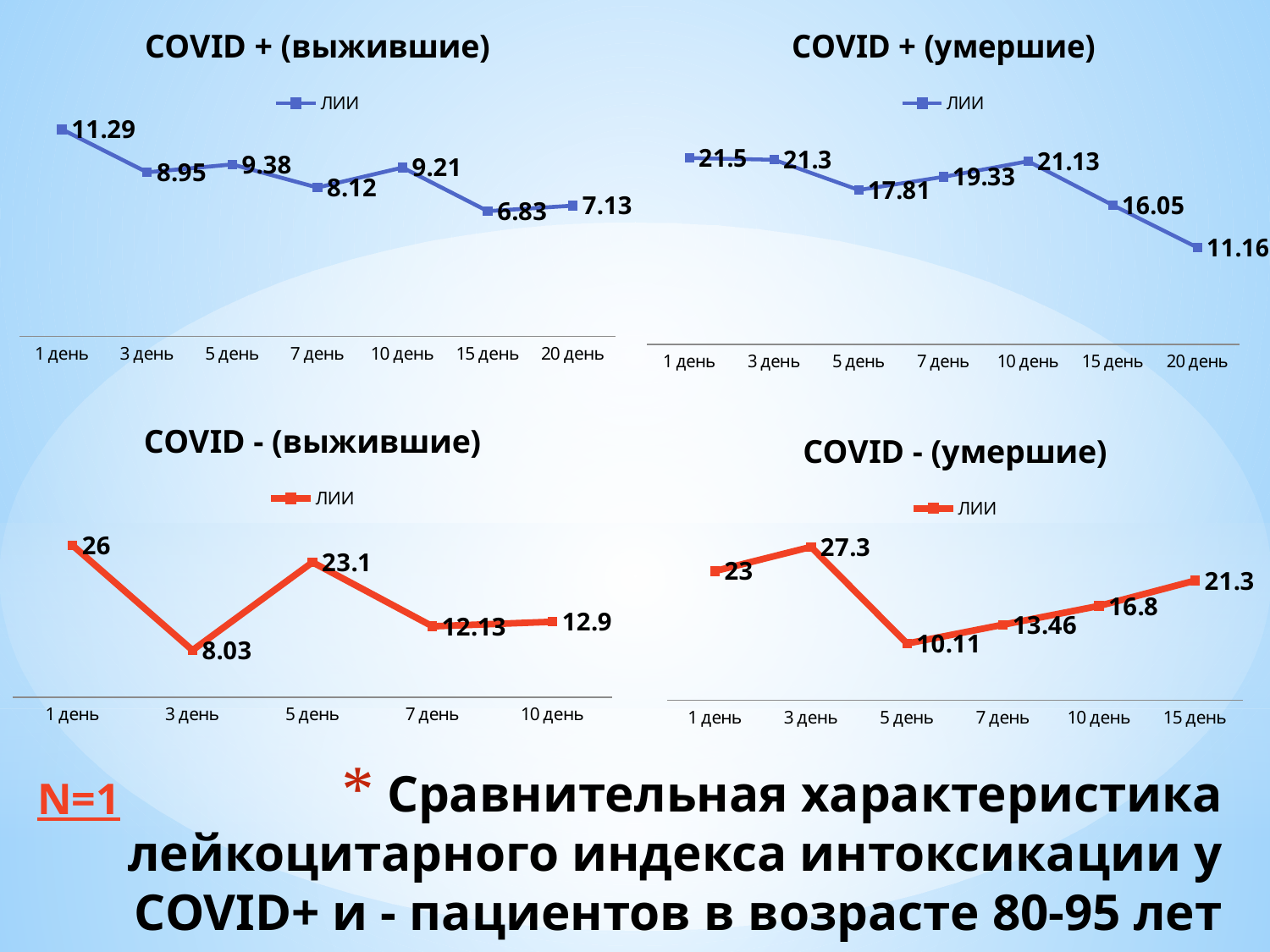
How many days are plotted in the "COVID + (выжившие)" chart? 7 What colour is the line in the "COVID + (выжившие)" chart? Blue In the "COVID + (умершие)" chart, what is the difference between the ЛИИ values on 1 день and 20 день? 10.34 In the "COVID - (умершие)" chart, which day has the highest ЛИИ value? 3 день How many days are plotted in the "COVID - (умершие)" chart? 6 In the "COVID + (умершие)" chart, what is the ЛИИ value on 20 день? 11.16 In the "COVID - (умершие)" chart, do the ЛИИ values rise or fall from 5 день to 15 день? Rise In the "COVID + (выжившие)" chart, what is the ЛИИ value on 1 день? 11.29 How many series does the legend of the "COVID - (выжившие)" chart list? 1 In the "COVID - (выжившие)" chart, which day has the lowest ЛИИ value? 3 день What type of chart is "COVID + (умершие)"? Line chart In the "COVID - (выжившие)" chart, which is larger: the ЛИИ value on 5 день or on 10 день? 5 день